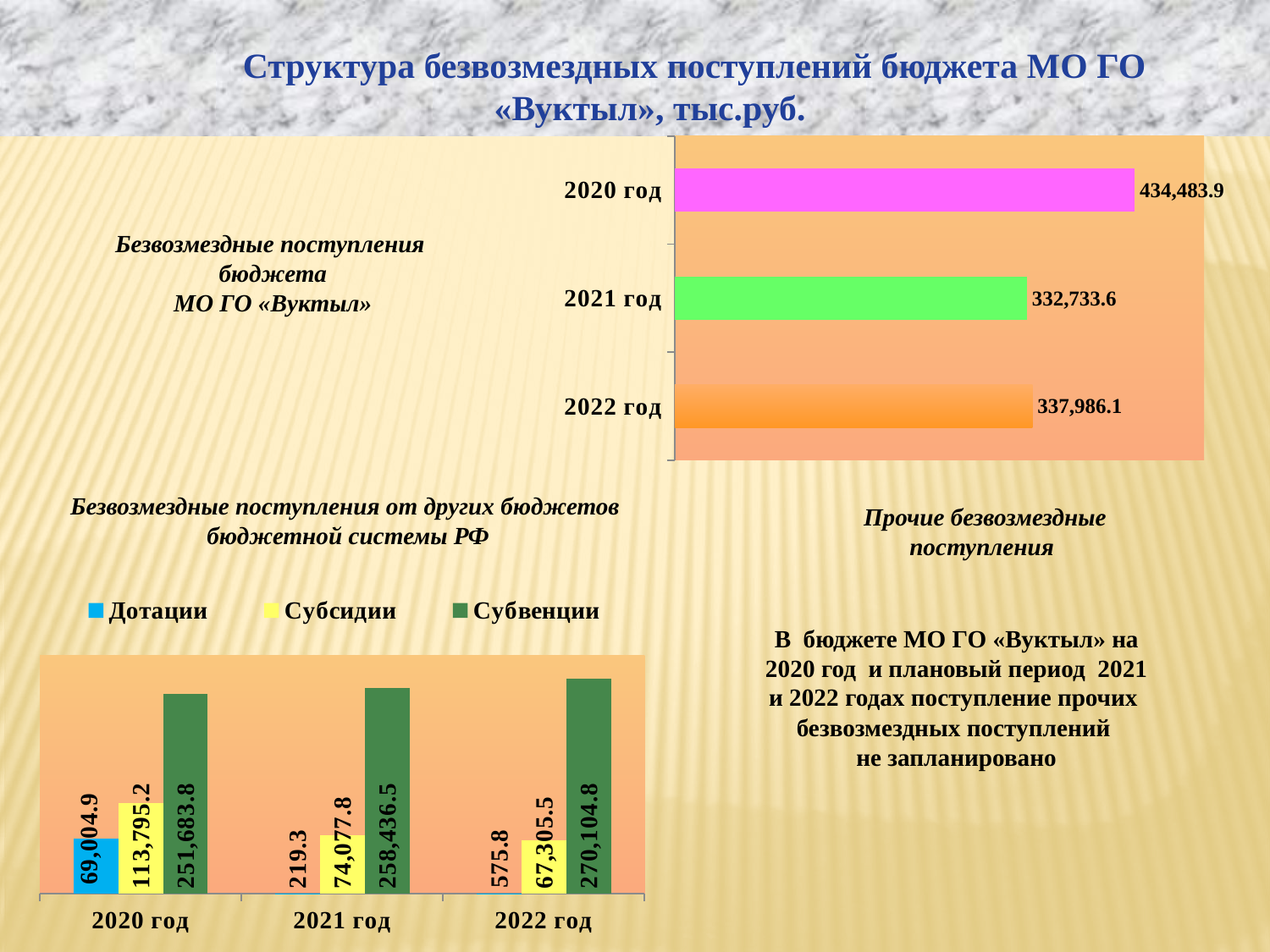
In the bottom-left chart (Безвозмездные поступления от других бюджетов бюджетной системы РФ), what is the value of Дотации for 2021 год? 219.3 In the top-right chart (Безвозмездные поступления бюджета МО ГО «Вуктыл»), which year has the lowest value? 2021 год In the top-right chart (Безвозмездные поступления бюджета МО ГО «Вуктыл»), which year has the highest value? 2020 год In the top-right chart (Безвозмездные поступления бюджета МО ГО «Вуктыл»), what is the difference between the 2020 год and 2021 год values? 101,750.3 In the bottom-left chart (Безвозмездные поступления от других бюджетов бюджетной системы РФ), which is larger: Субсидии for 2020 год or Субсидии for 2021 год? Субсидии for 2020 год In the top-right chart (Безвозмездные поступления бюджета МО ГО «Вуктыл»), what is the value for 2020 год? 434,483.9 In the top-right chart (Безвозмездные поступления бюджета МО ГО «Вуктыл»), how many years are shown? 3 In the bottom-left chart (Безвозмездные поступления от других бюджетов бюджетной системы РФ), how many series does the legend list? 3 In the top-right chart (Безвозмездные поступления бюджета МО ГО «Вуктыл»), what is the value for 2021 год? 332,733.6 In the bottom-left chart (Безвозмездные поступления от других бюджетов бюджетной системы РФ), what is the value of Субвенции for 2022 год? 270,104.8 In the bottom-left chart (Безвозмездные поступления от других бюджетов бюджетной системы РФ), what is the difference between Субвенции for 2022 год and Субвенции for 2020 год? 18,421.0 What kind of chart is the top-right chart (Безвозмездные поступления бюджета МО ГО «Вуктыл»)? bar chart